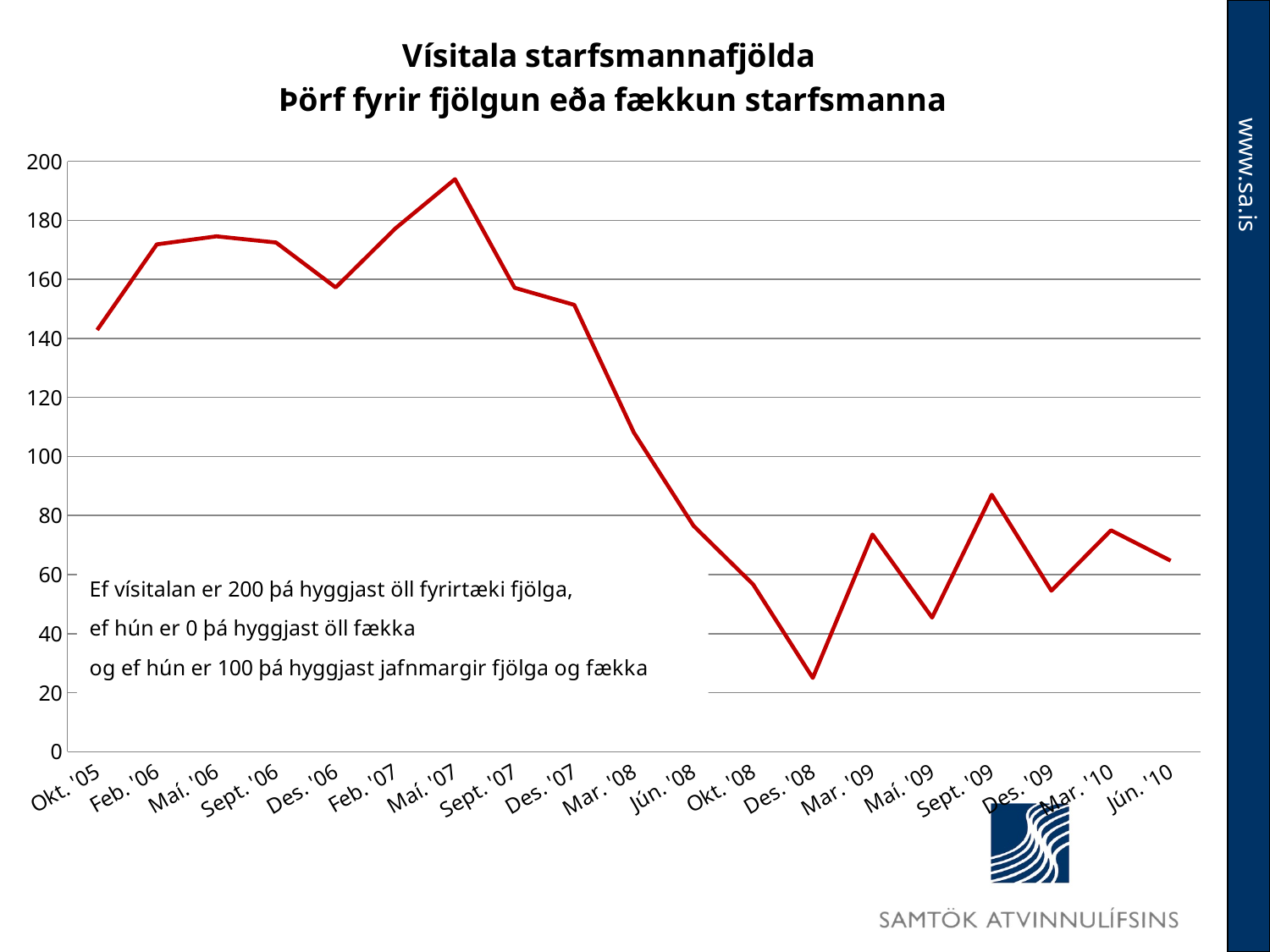
Is the value for Jún. '10 greater or less than 80? less Which month has the lowest value of the index? Des. '08 Overall, does the index rise or fall from Okt. '05 to Jún. '10? fall What kind of chart is shown on the slide? line chart Is the value for Okt. '05 greater or less than 120? greater Is the value for Mar. '08 greater or less than 100? greater Which month has the highest value of the index? Maí. '07 Which is larger, the value for Sept. '09 or the value for Maí. '09? Sept. '09 How many months are labelled on the x axis? 19 Which is larger, the value for Feb. '06 or the value for Mar. '09? Feb. '06